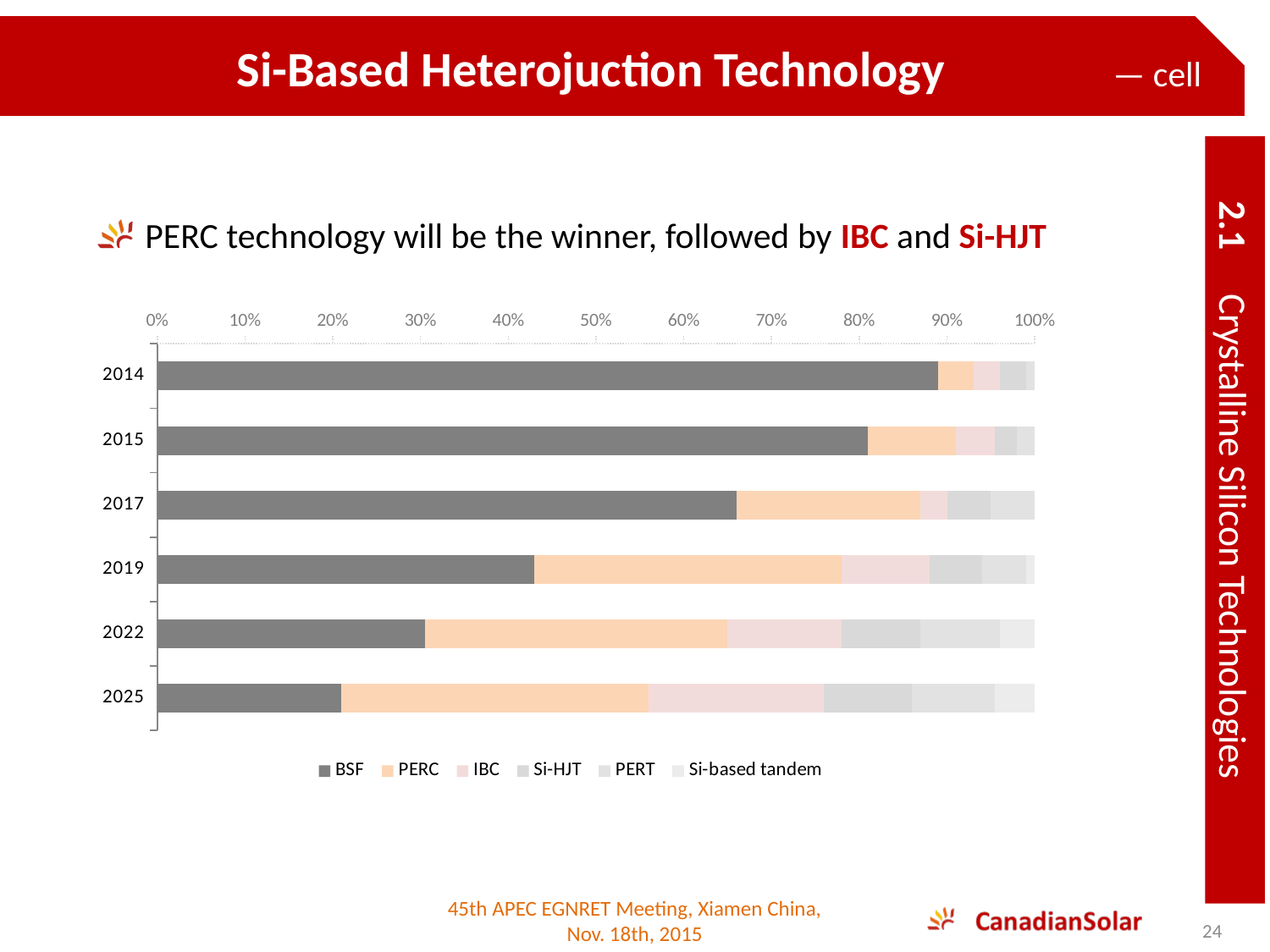
Does the BSF share rise or fall from 2014 to 2025? fall Which year has the larger PERC segment, 2014 or 2025? 2025 Which series is listed first in the chart legend? BSF What kind of chart is shown on the slide? bar chart How many series does the chart legend list? 6 Is the BSF share for 2019 greater or less than 40%? greater Which year has the largest BSF segment? 2014 Is the BSF share for 2014 greater or less than 80%? greater Which year has the smallest BSF segment? 2025 Is the BSF share for 2025 greater or less than 30%? less How many years (categories) are plotted on the chart? 6